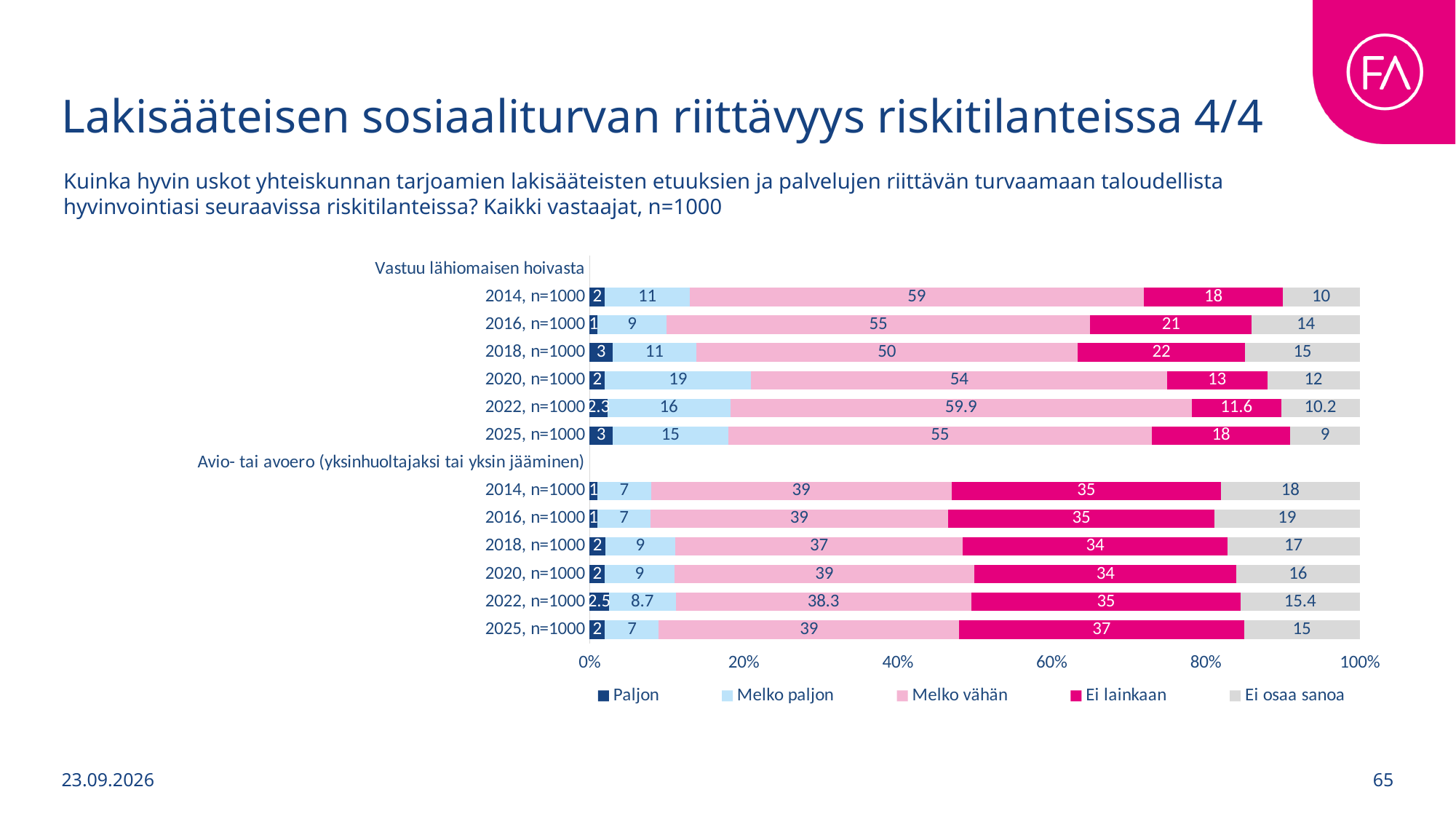
Which is larger: the 'Ei osaa sanoa' value for 'Avio- tai avoero' in 2014, n=1000 or in 2025, n=1000? 2014, n=1000 What is the 'Melko paljon' value for 'Avio- tai avoero (yksinhuoltajaksi tai yksin jääminen)' in 2022, n=1000? 8.7 What is the 'Ei osaa sanoa' value for 'Vastuu lähiomaisen hoivasta' in 2016, n=1000? 14 Which legend entry is shown in dark blue? Paljon What is the 'Melko vähän' value for 'Vastuu lähiomaisen hoivasta' in 2022, n=1000? 59.9 Among the 'Vastuu lähiomaisen hoivasta' bars, which year has the lowest 'Ei lainkaan' value? 2022, n=1000 How many bars are plotted in the chart in total? 12 Among the 'Vastuu lähiomaisen hoivasta' bars, which year has the highest 'Melko paljon' value? 2020, n=1000 What is the 'Ei lainkaan' value for 'Avio- tai avoero (yksinhuoltajaksi tai yksin jääminen)' in 2025, n=1000? 37 What is the difference between the 'Ei lainkaan' values for 'Vastuu lähiomaisen hoivasta' in 2018, n=1000 and 2020, n=1000? 9 What kind of chart is shown on the slide? stacked bar chart How many series does the legend list? 5